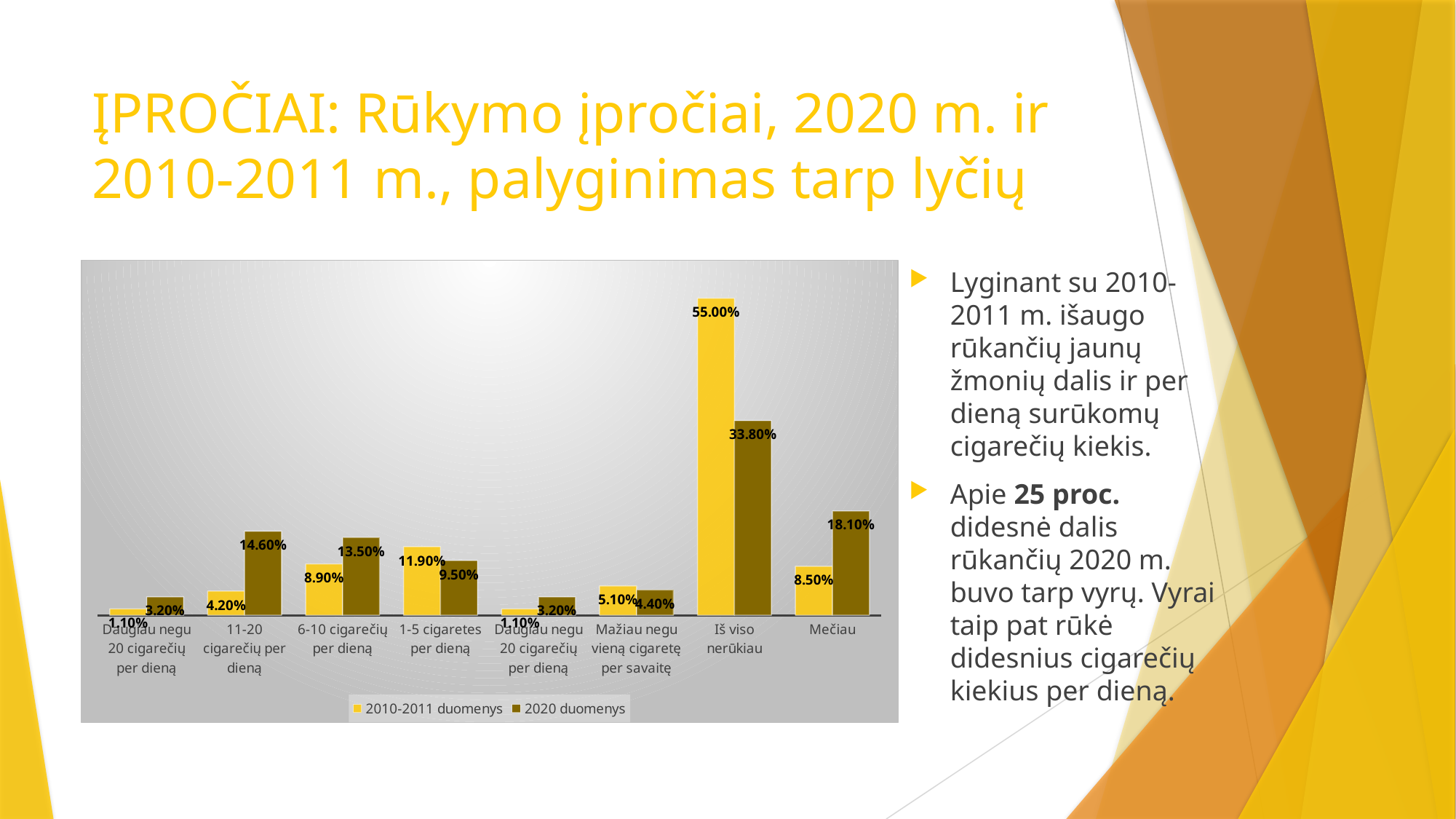
What is the difference between the 2010-2011 duomenys and 2020 duomenys values for "Iš viso nerūkiau"? 21.20% What is the value for "1-5 cigaretes per dieną" in the 2010-2011 duomenys series? 11.90% What is the difference between the 2020 duomenys and 2010-2011 duomenys values for "Mečiau"? 9.60% What are the two series named in the chart legend? 2010-2011 duomenys and 2020 duomenys For "6-10 cigarečių per dieną", which series has the larger value: 2010-2011 duomenys or 2020 duomenys? 2020 duomenys Which category has the highest value in the 2020 duomenys series? Iš viso nerūkiau What is the value for "Iš viso nerūkiau" in the 2010-2011 duomenys series? 55.00% What is the value for "11-20 cigarečių per dieną" in the 2020 duomenys series? 14.60% What is the value for "Mečiau" in the 2020 duomenys series? 18.10% What kind of chart is shown on the slide? Bar chart How many series does the chart legend list? 2 How many categories are shown along the x axis of the chart? 8